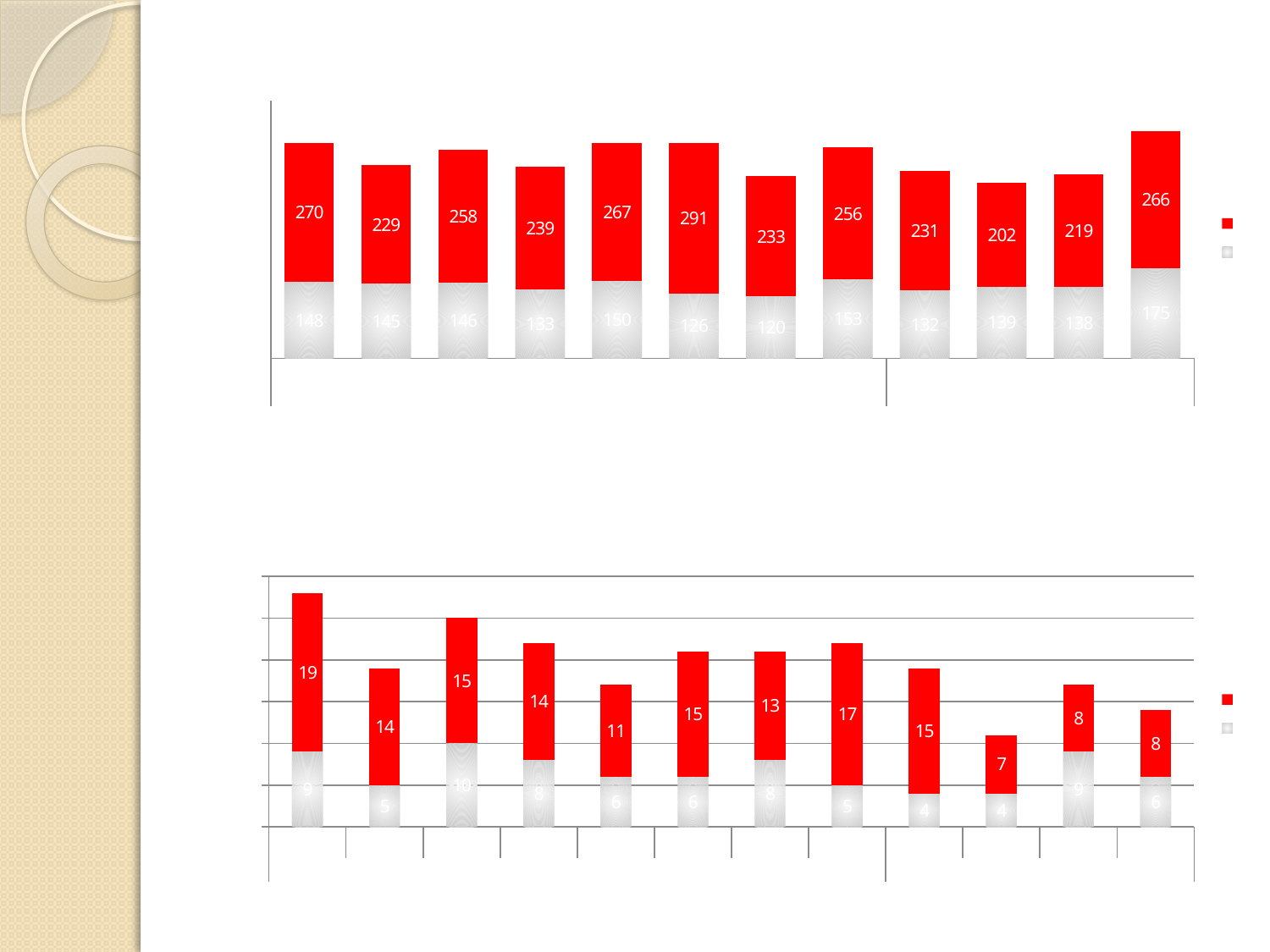
In the bottom chart, what is the value of the red segment of the first bar? 19 How many bars does the top chart have? 12 In the top chart, what is the value of the red segment of the first bar? 270 In the bottom chart, which bar has the lowest red segment value? the tenth bar (7) In the top chart, what is the difference between the highest red value (291) and the lowest red value (202)? 89 In the top chart, which bar has the lowest red segment value? the tenth bar (202) In the top chart, what is the total of the first stacked bar? 418 In the bottom chart, is the red segment of the first bar (19) larger or smaller than the red segment of the second bar (14)? larger What kind of chart is the top chart on the slide? bar chart In the top chart, what is the value of the grey segment of the last (twelfth) bar? 175 How many series does the legend of the bottom chart list? 2 In the top chart, which bar has the highest red segment value? the sixth bar (291)